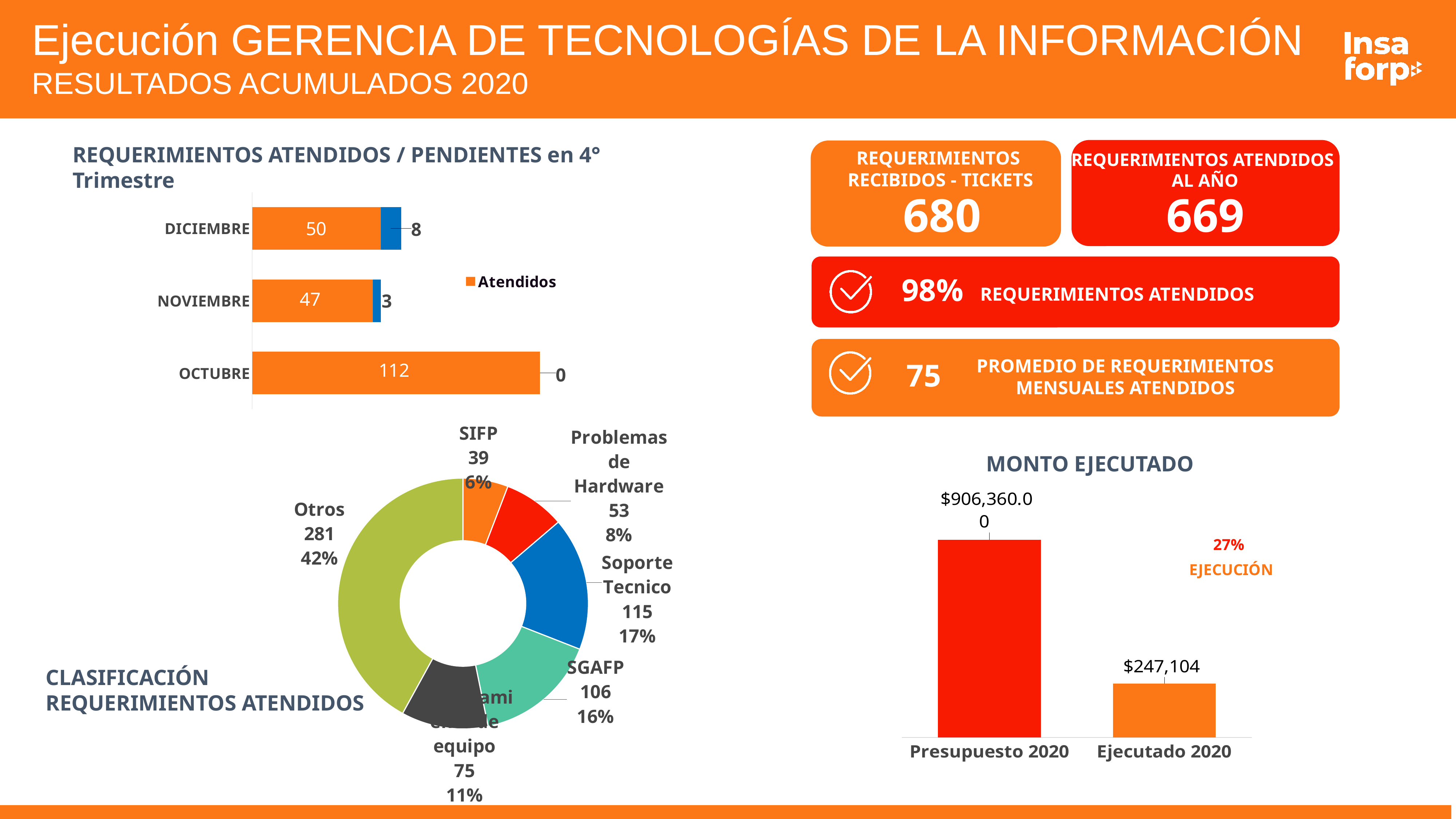
In the CLASIFICACIÓN REQUERIMIENTOS ATENDIDOS donut chart, what share does Otros represent? 42% What type of chart is the REQUERIMIENTOS ATENDIDOS / PENDIENTES en 4° Trimestre chart? Bar chart In the MONTO EJECUTADO chart, which category has the higher value? Presupuesto 2020 In the CLASIFICACIÓN REQUERIMIENTOS ATENDIDOS donut chart, which category has the smallest value? SIFP In the CLASIFICACIÓN REQUERIMIENTOS ATENDIDOS donut chart, which is larger, SGAFP or Problemas de Hardware? SGAFP In the MONTO EJECUTADO chart, what is the value for Ejecutado 2020? $247,104 In the REQUERIMIENTOS ATENDIDOS / PENDIENTES en 4° Trimestre chart, how many requerimientos atendidos are shown for OCTUBRE? 112 In the REQUERIMIENTOS ATENDIDOS / PENDIENTES en 4° Trimestre chart, how many months are shown? 3 In the REQUERIMIENTOS ATENDIDOS / PENDIENTES en 4° Trimestre chart, what is the difference between the atendidos values for DICIEMBRE and NOVIEMBRE? 3 In the REQUERIMIENTOS ATENDIDOS / PENDIENTES en 4° Trimestre chart, which month has the highest number of atendidos? OCTUBRE In the CLASIFICACIÓN REQUERIMIENTOS ATENDIDOS donut chart, what is the value for Soporte Tecnico? 115 In the REQUERIMIENTOS ATENDIDOS / PENDIENTES en 4° Trimestre chart, what is the pendientes value for DICIEMBRE? 8